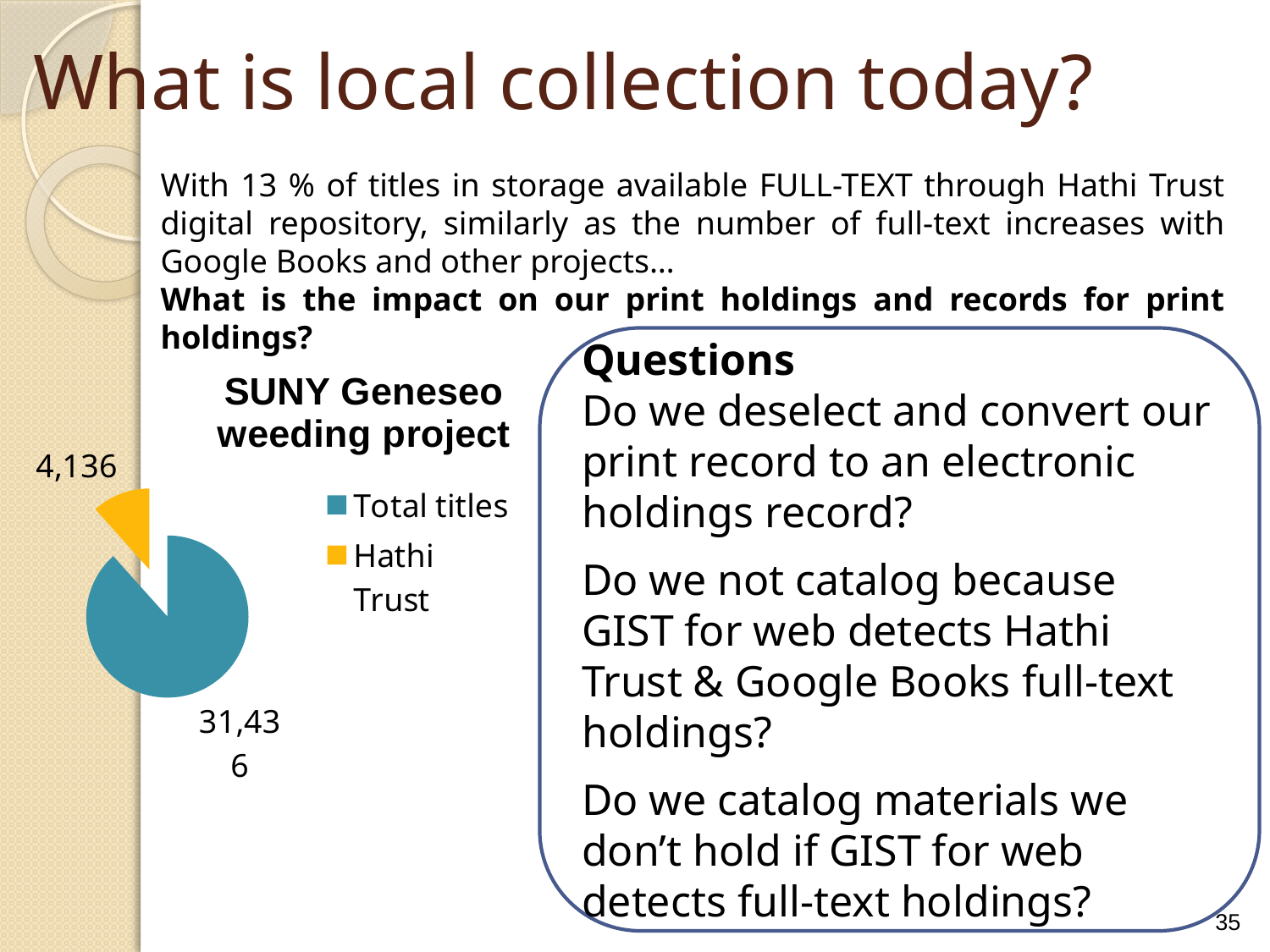
How many slices does the pie chart have? 2 What type of chart is shown on the slide? pie chart What is the difference between the Total titles value and the Hathi Trust value? 27,300 What colour is the Hathi Trust slice in the pie chart? yellow What is the title of the chart? SUNY Geneseo weeding project How many entries does the chart legend list? 2 Which is larger, Total titles or Hathi Trust? Total titles Which slice of the pie chart is the smallest? Hathi Trust What is the value for Total titles in the pie chart? 31,436 What is the value for Hathi Trust in the pie chart? 4,136 Which slice of the pie chart is the largest? Total titles What is the sum of the two values shown in the pie chart? 35,572